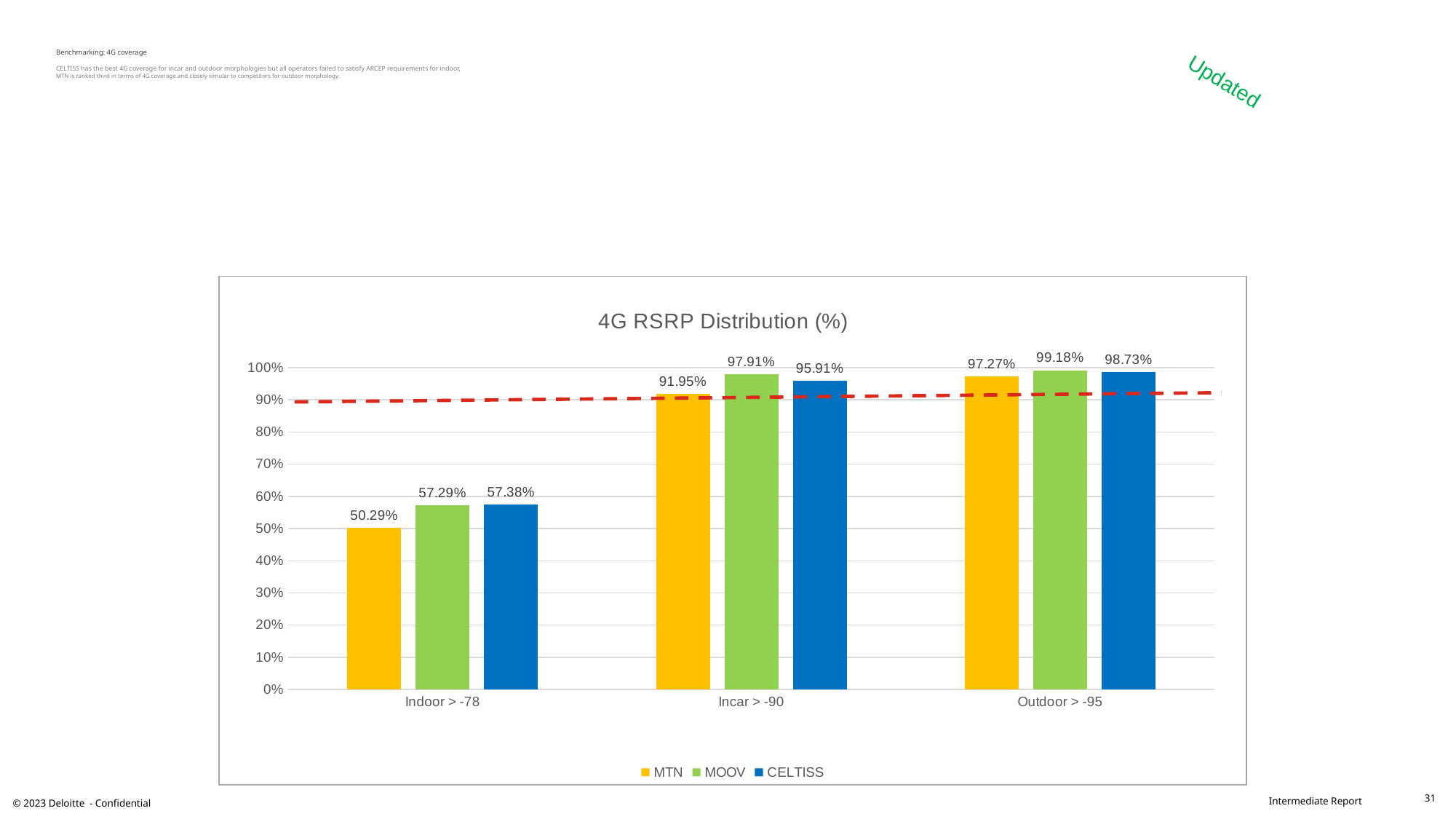
How many categories are shown on the x axis? 3 What is the difference between the MOOV and MTN values in the Incar > -90 category? 5.96% What kind of chart is shown on the slide? Bar chart What is the title of the chart? 4G RSRP Distribution (%) Which series has the highest value in the Incar > -90 category? MOOV What is the value for MOOV in the Outdoor > -95 category? 99.18% Is the value for CELTISS in the Indoor > -78 category greater or less than 60%? less Which series has the lowest value in the Indoor > -78 category? MTN What is the value for CELTISS in the Incar > -90 category? 95.91% How many series does the legend list? 3 What is the value for MTN in the Indoor > -78 category? 50.29% Which is larger: the MTN value for Incar > -90 or the MTN value for Outdoor > -95? Outdoor > -95